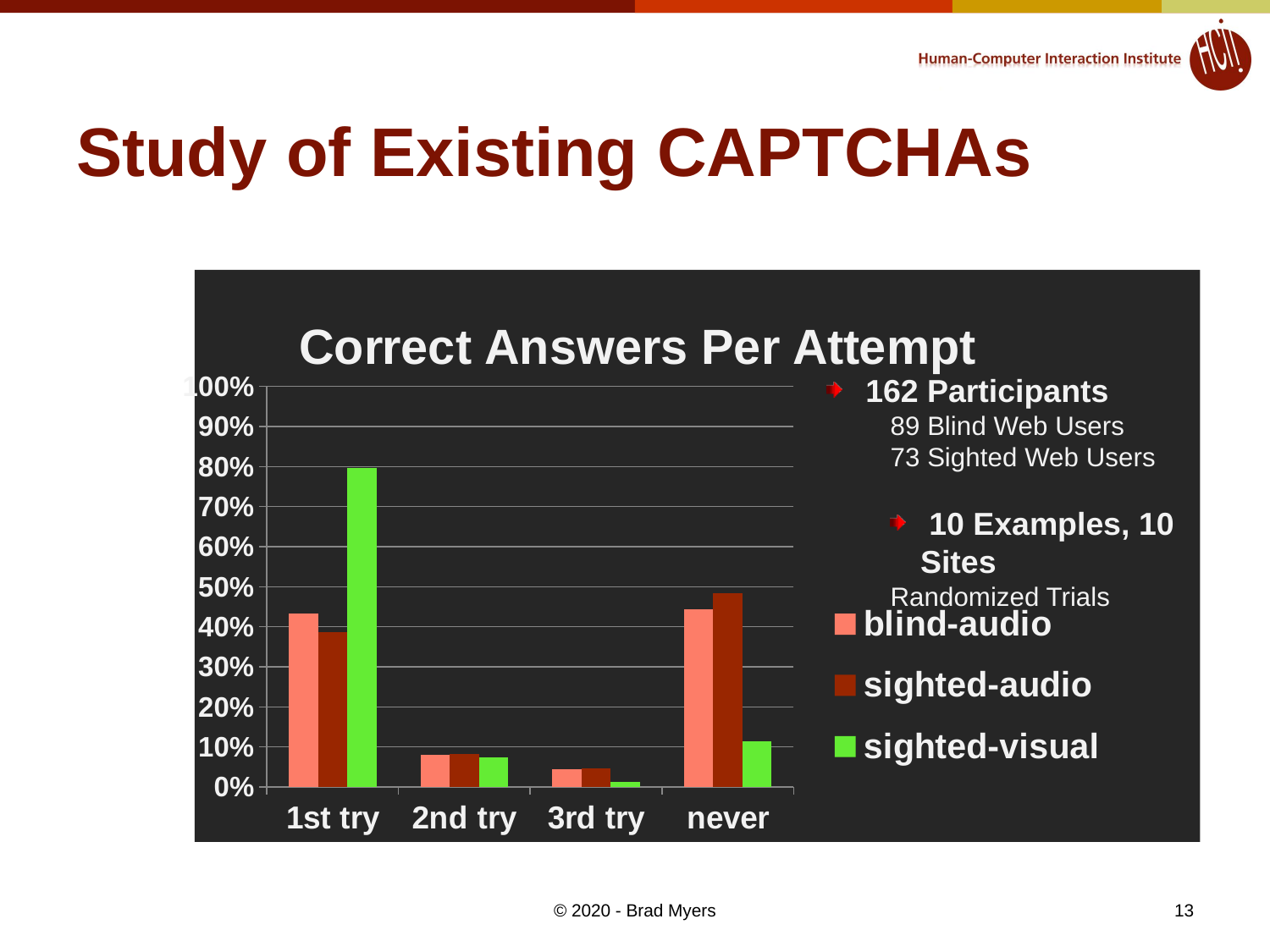
Which series is shown in green in the chart? sighted-visual At 1st try, which is larger: blind-audio or sighted-visual? sighted-visual Is the value for sighted-visual at never greater or less than 20%? less How many categories are shown on the x axis of the chart? 4 Is the value for sighted-visual at 1st try greater or less than 70%? greater Is the value for sighted-audio at never greater or less than 40%? greater How many series does the chart's legend list? 3 For the sighted-visual series, which category has the highest value? 1st try What is the title of the chart? Correct Answers Per Attempt For the sighted-audio series, which category has the highest value? never What kind of chart is shown on the slide? bar chart